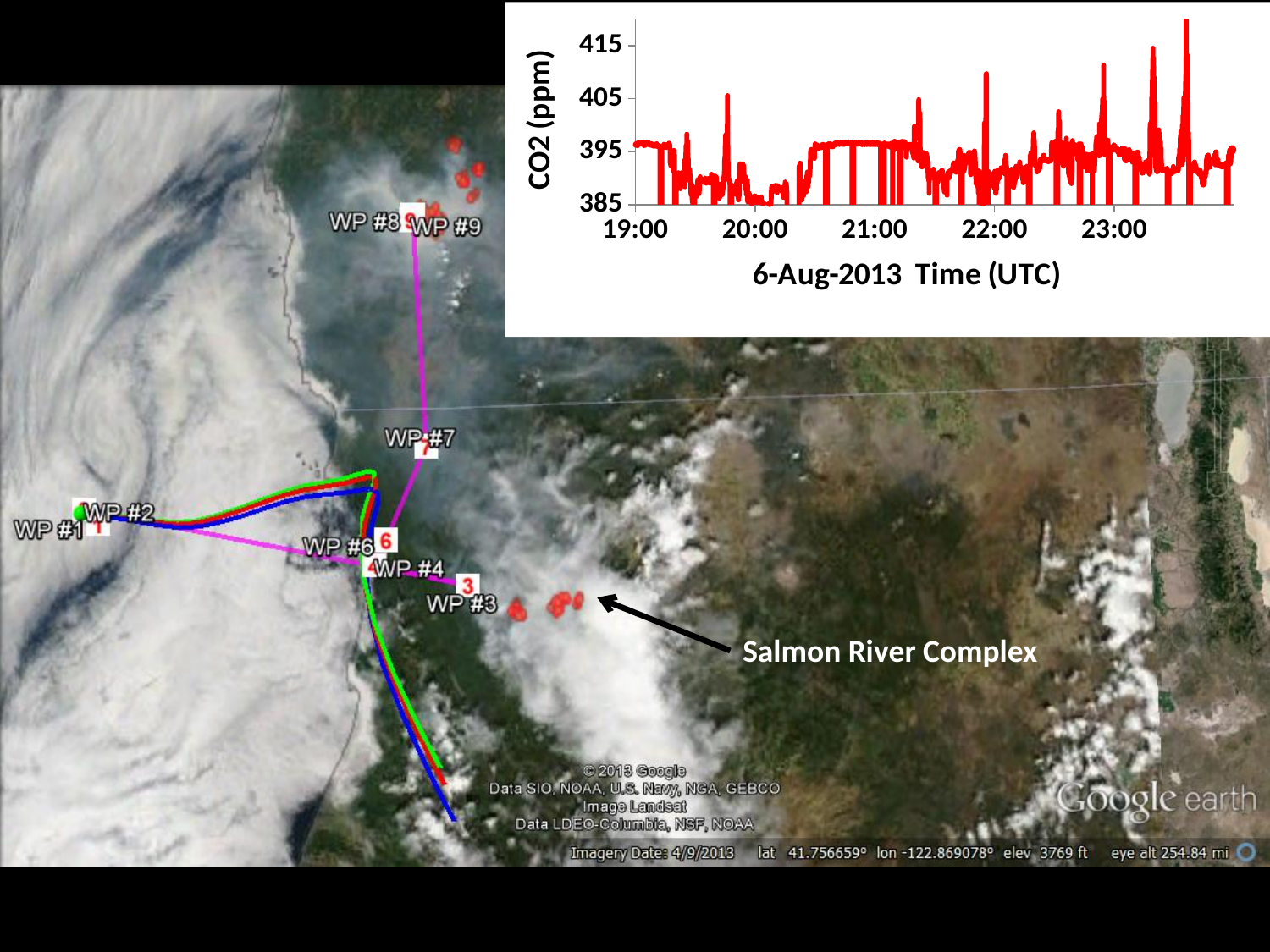
What is the lowest value shown on the y axis of the CO2 chart? 385 In the CO2 chart, is the peak near 23:30 greater or less than 405 ppm? greater What is the label of the x axis of the CO2 chart? 6-Aug-2013 Time (UTC) How many data series are plotted in the CO2 chart? 1 In the CO2 chart, is the highest peak (shortly before 24:00) greater or less than 415 ppm? greater In the CO2 chart, is the peak just before 22:00 greater or less than 405 ppm? greater What kind of chart is shown in the top-right of the slide? line chart What is the label of the y axis of the CO2 chart? CO2 (ppm)